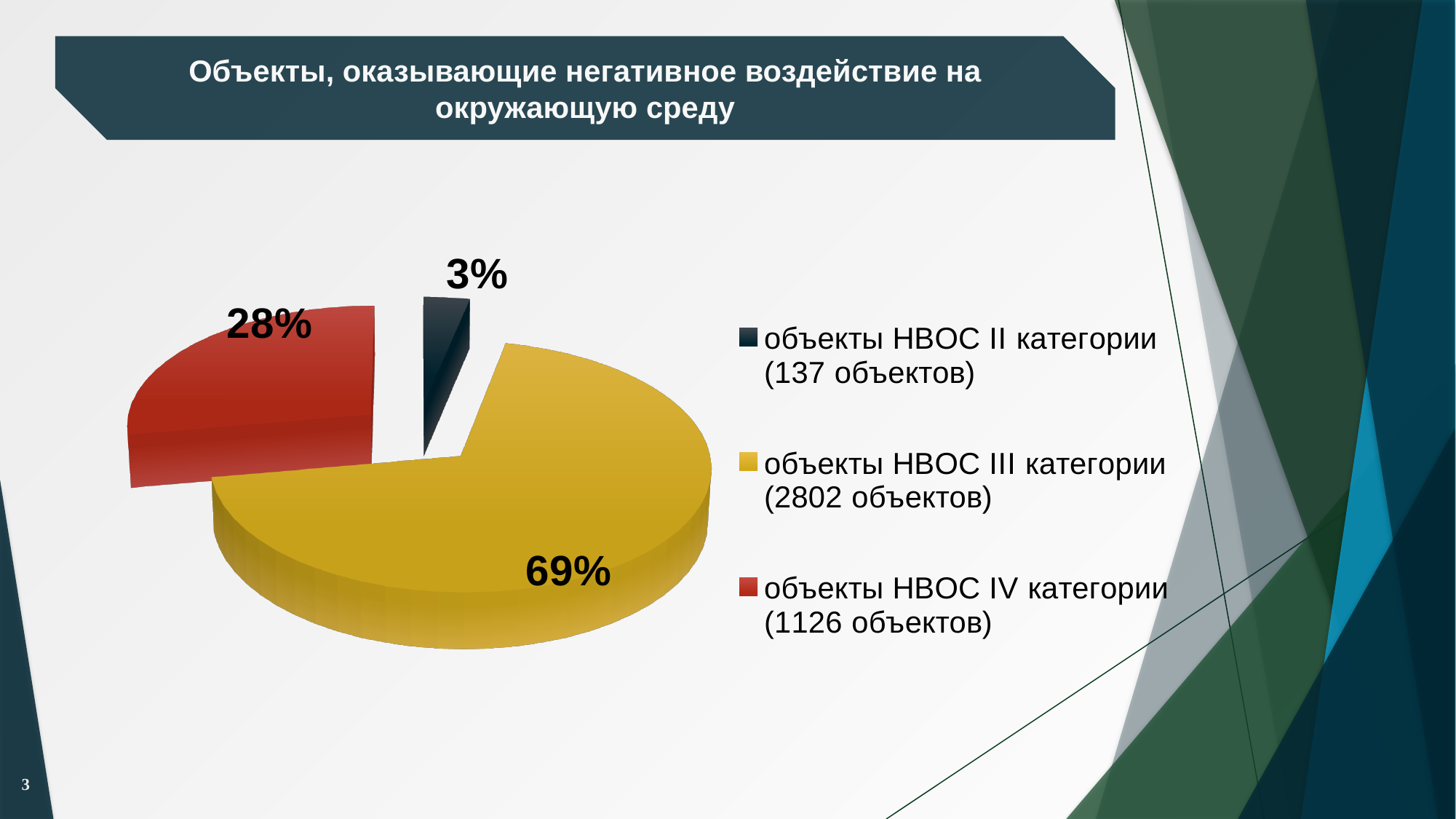
How many slices does the pie chart have? 3 What kind of chart is shown on the slide? pie chart Which category has the largest slice of the pie? объекты НВОС III категории What share of the pie is labelled for объекты НВОС III категории? 69% Which is larger: the share for объекты НВОС IV категории or the share for объекты НВОС II категории? объекты НВОС IV категории How many objects does the legend give for объекты НВОС III категории? 2802 объектов Which category has the smallest slice of the pie? объекты НВОС II категории What is the difference in percentage points between the share for объекты НВОС III категории and the share for объекты НВОС IV категории? 41% What share of the pie is labelled for объекты НВОС IV категории? 28% What share of the pie is labelled for объекты НВОС II категории? 3% What colour is the slice for объекты НВОС IV категории? red How many entries does the legend list? 3